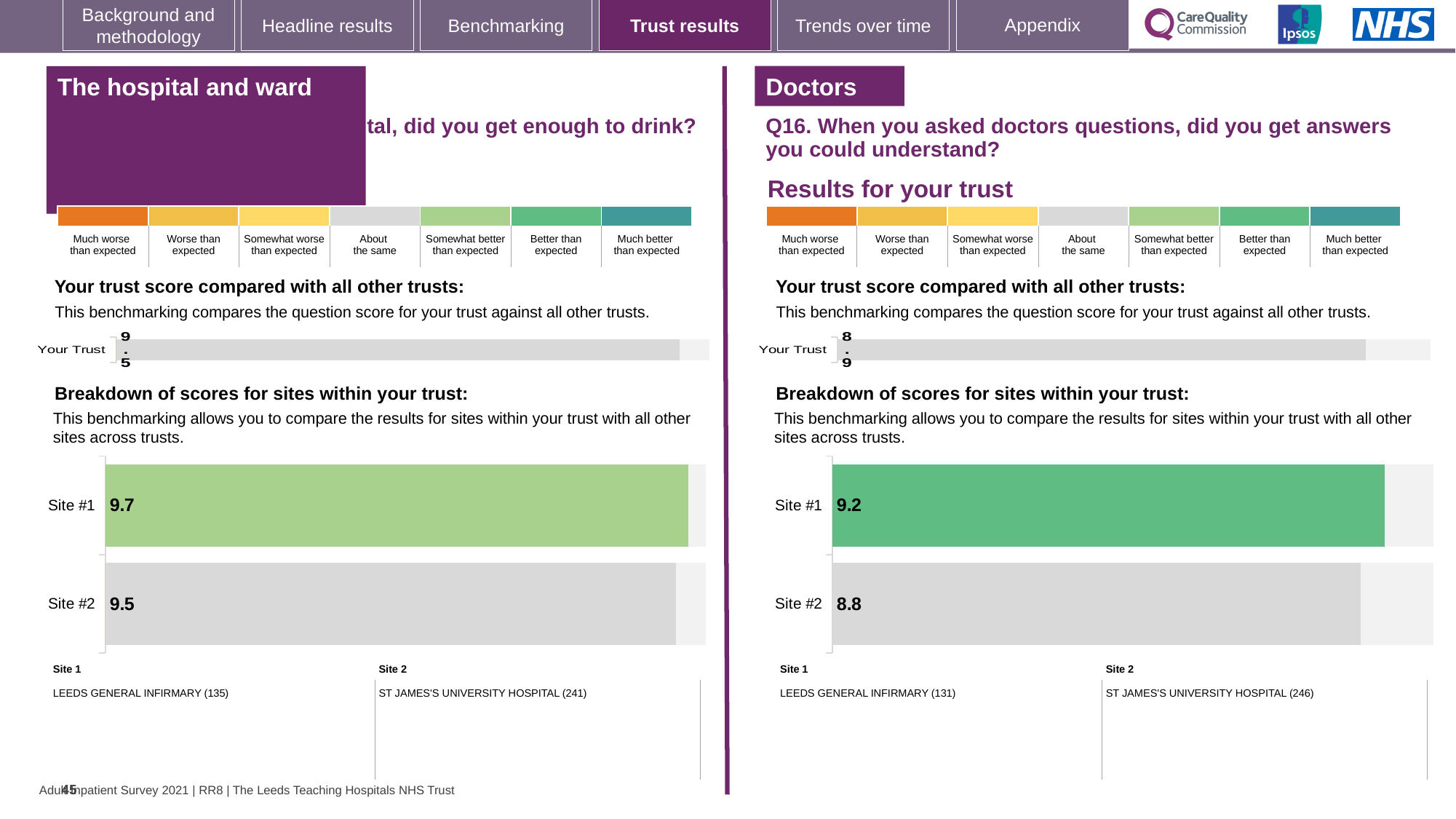
In the Q16 'Your trust score compared with all other trusts' chart on the right, what is the score shown for Your Trust? 8.9 In the left-hand site breakdown chart, which site has the lower score? Site #2 In the left-hand 'Your trust score compared with all other trusts' chart, what is the score shown for Your Trust? 9.5 In the left-hand 'Breakdown of scores for sites within your trust' chart, what is the score for Site #2? 9.5 How many sites are shown in the Q16 site breakdown chart on the right? 2 In the Q16 site breakdown chart on the right, what is the difference between the Site #1 and Site #2 scores? 0.4 What type of chart is used for the site breakdown on the left-hand side of the slide? Bar chart In the Q16 'Breakdown of scores for sites within your trust' chart on the right, what is the score for Site #1? 9.2 In the Q16 site breakdown chart on the right, which site has the higher score? Site #1 In the Q16 'Breakdown of scores for sites within your trust' chart on the right, what is the score for Site #2? 8.8 In the left-hand 'Breakdown of scores for sites within your trust' chart, what is the score for Site #1? 9.7 In the left-hand site breakdown chart, what is the difference between the Site #1 and Site #2 scores? 0.2